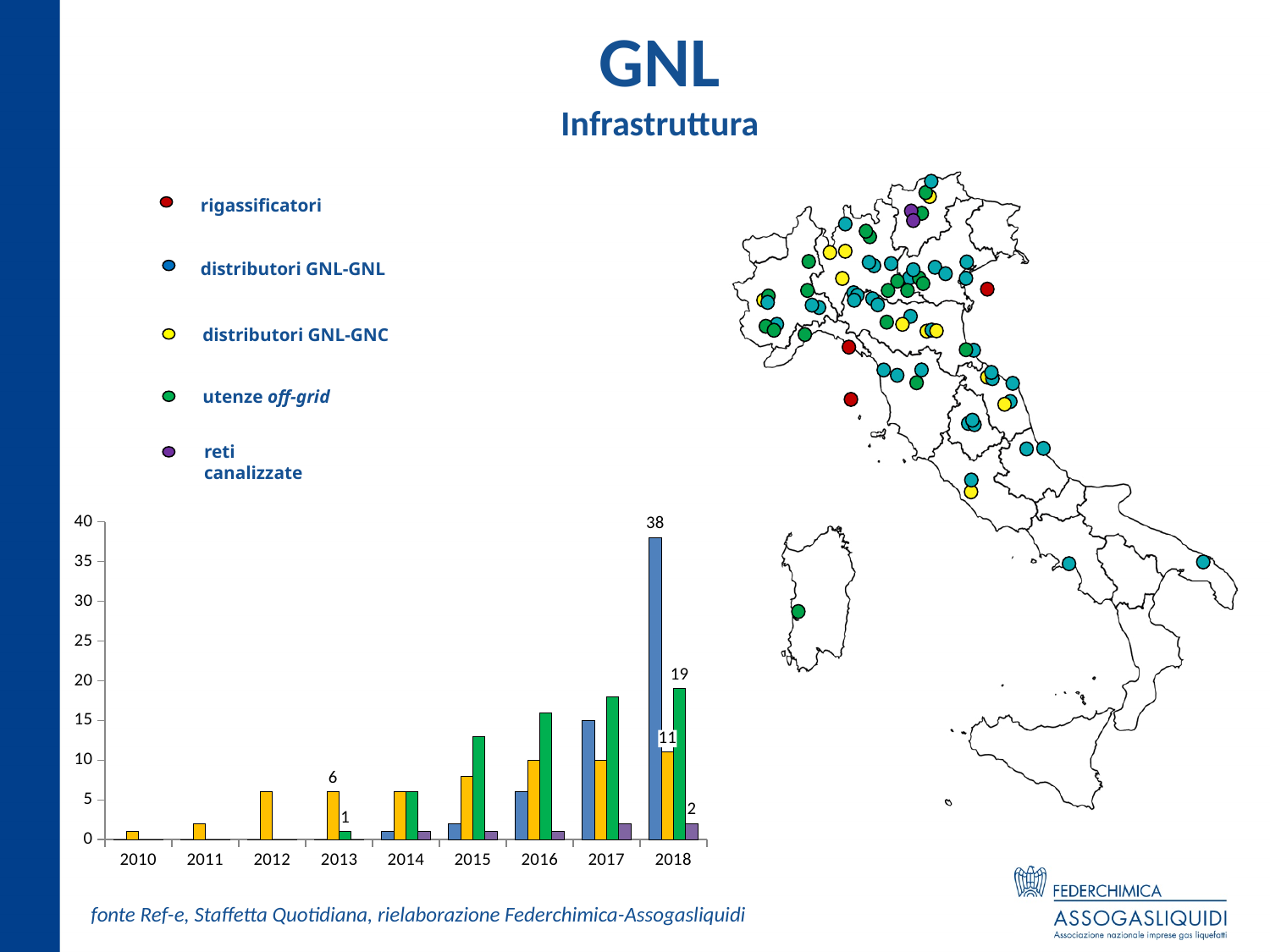
In the bar chart, which is larger in 2018: the blue bar or the yellow bar? the blue bar In the bar chart, what is the value of the yellow bar (distributori GNL-GNC) for 2013? 6 In the bar chart, do the blue bars rise or fall from 2016 to 2018? rise In the bar chart, is the value of the green bar for 2017 greater or less than 15? greater In the bar chart, what is the value of the purple bar (reti canalizzate) for 2018? 2 In the bar chart, what is the difference between the blue bar and the green bar in 2018? 19 In the bar chart, is the value of the green bar for 2015 greater or less than 10? greater In the bar chart, what is the value of the yellow bar (distributori GNL-GNC) for 2018? 11 In the bar chart, what is the value of the green bar (utenze off-grid) for 2018? 19 What kind of chart is shown at the bottom left of the slide? bar chart In the bar chart, what is the value of the blue bar (distributori GNL-GNL) for 2018? 38 How many years are shown on the x axis of the bar chart? 9